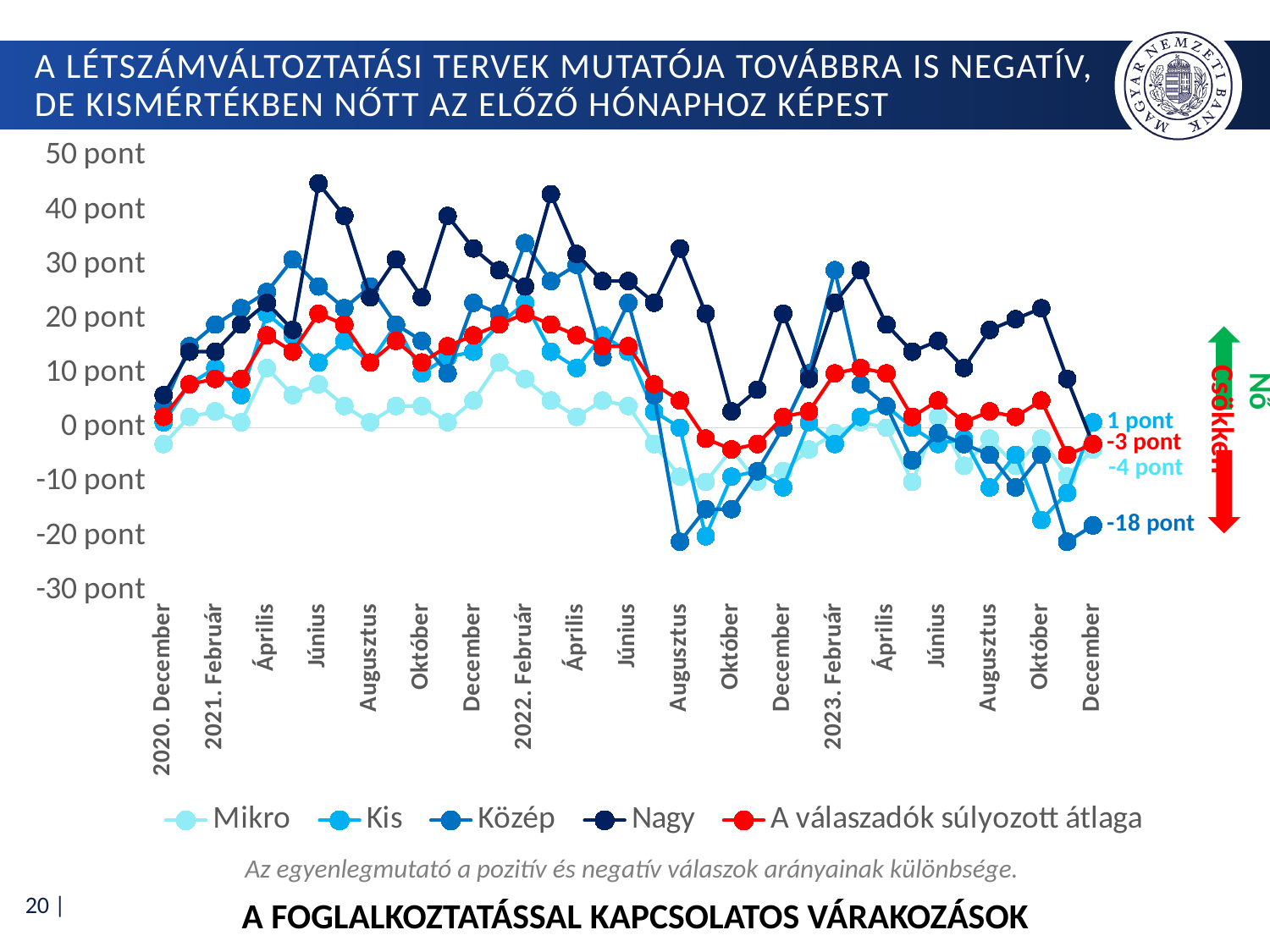
What is the title shown below the chart? A FOGLALKOZTATÁSSAL KAPCSOLATOS VÁRAKOZÁSOK Does 'A válaszadók súlyozott átlaga' rise or fall between February 2022 and October 2022? fall Which series has the lowest value at the last point (December 2023)? Közép What are the series names listed in the legend? Mikro, Kis, Közép, Nagy, A válaszadók súlyozott átlaga Is the value for 'Nagy' in August 2022 greater or less than 20 pont? greater What kind of chart is shown on the slide? line chart How many series does the legend list? 5 Is the value for 'A válaszadók súlyozott átlaga' in February 2022 greater or less than 10 pont? greater Is the value for 'Nagy' in June 2021 greater or less than 40 pont? greater What is the value of 'A válaszadók súlyozott átlaga' at the last point (December 2023)? -3 pont